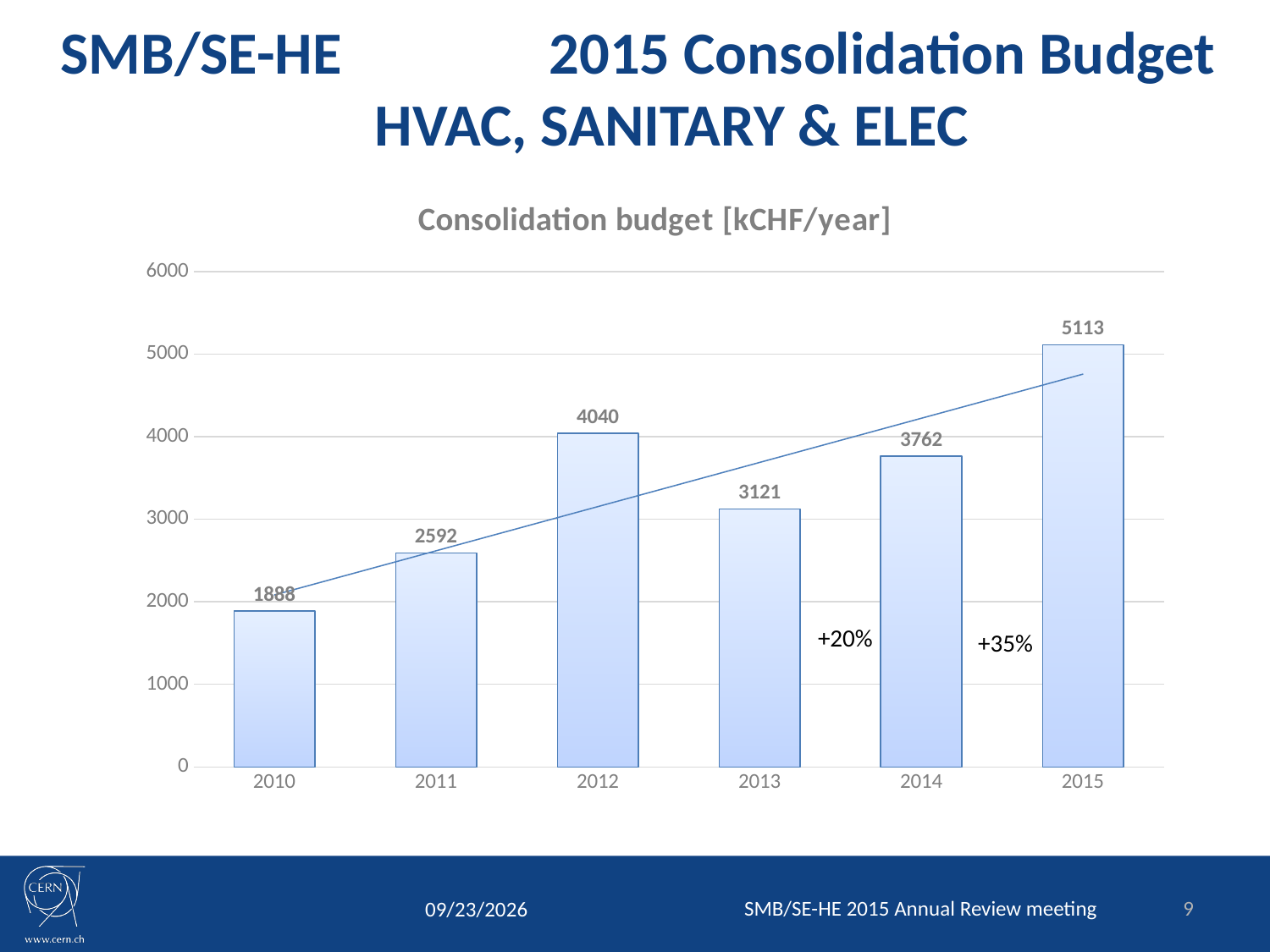
Which year has the lowest consolidation budget? 2010 What is the consolidation budget for 2010? 1888 What is the difference between the 2015 and 2014 consolidation budgets? 1351 Which year has the highest consolidation budget? 2015 What is the consolidation budget for 2015? 5113 Does the consolidation budget rise or fall from 2013 to 2015? rise Is the value for 2011 greater or less than 3000? less What is the title of the chart? Consolidation budget [kCHF/year] Which year has a larger consolidation budget, 2012 or 2013? 2012 How many years are shown on the x axis? 6 What kind of chart is shown on the slide? bar chart What is the consolidation budget for 2012? 4040